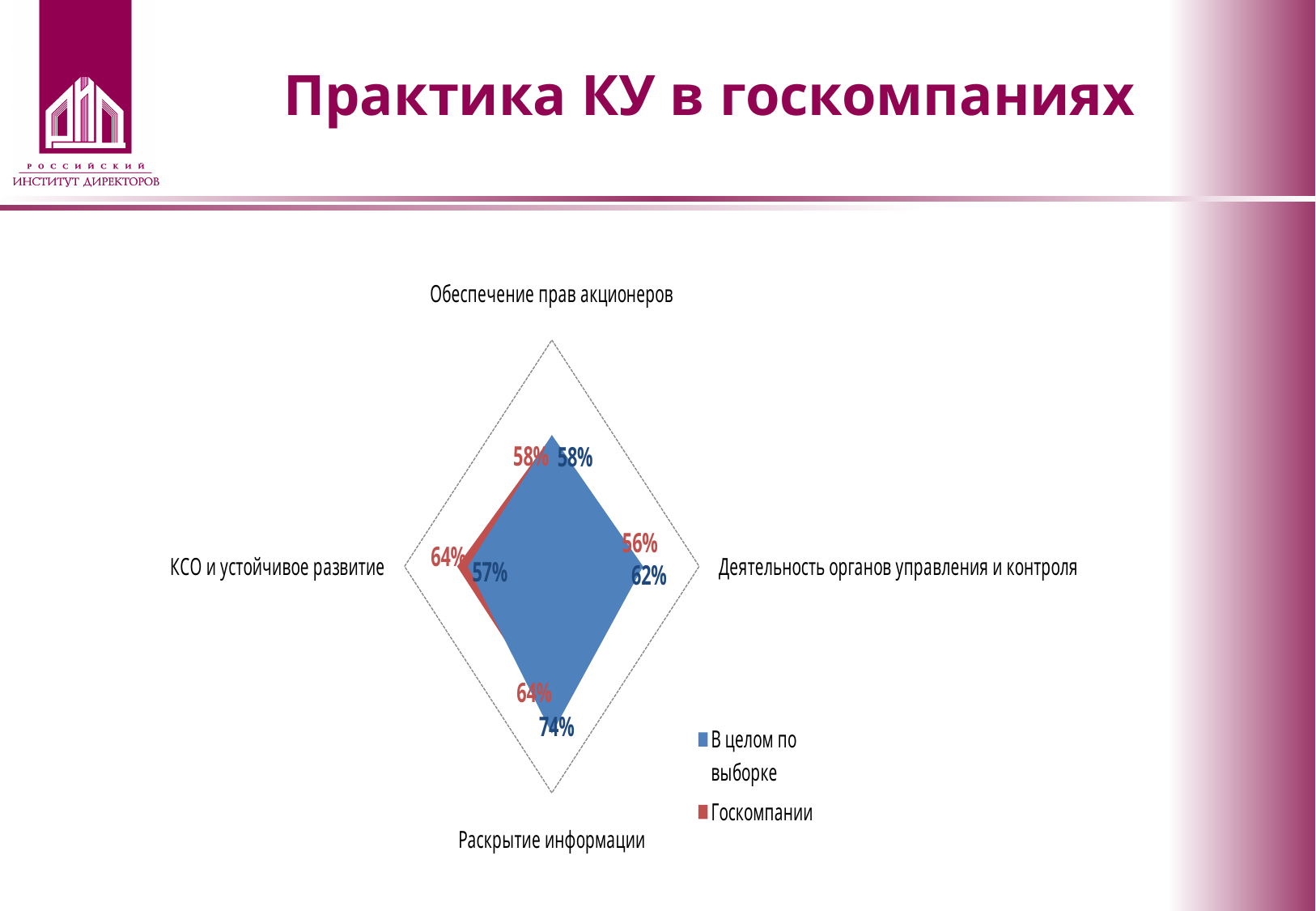
What is the value for Госкомпании on Деятельность органов управления и контроля? 56% What is the difference between В целом по выборке and Госкомпании on Раскрытие информации? 10% On КСО и устойчивое развитие, which series has the larger value: Госкомпании or В целом по выборке? Госкомпании How many categories (axes) does the radar chart have? 4 How many series does the legend list? 2 What is the value for В целом по выборке on КСО и устойчивое развитие? 57% Which category has the lowest value for the Госкомпании series? Деятельность органов управления и контроля What type of chart is shown on the slide? radar chart What is the value for Госкомпании on Раскрытие информации? 64% What is the value for Обеспечение прав акционеров for the Госкомпании series? 58% What is the value for В целом по выборке on Раскрытие информации? 74% Which category has the highest value for the В целом по выборке series? Раскрытие информации